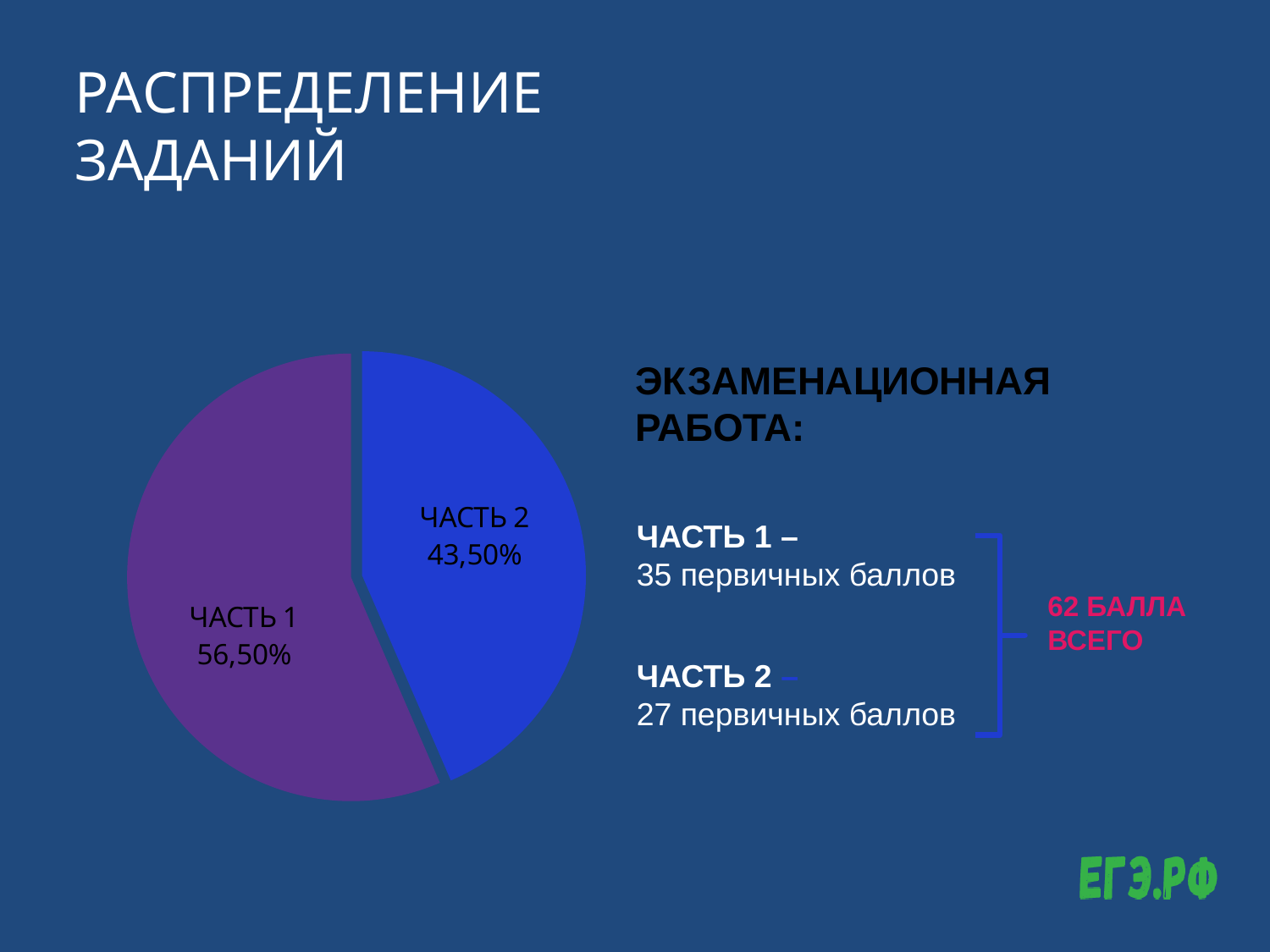
What share of the pie does ЧАСТЬ 2 have? 43,50% Which is larger, the share for ЧАСТЬ 1 or the share for ЧАСТЬ 2? ЧАСТЬ 1 Is the share for ЧАСТЬ 1 greater or less than 50%? greater What is the title of the slide containing the pie chart? РАСПРЕДЕЛЕНИЕ ЗАДАНИЙ What colour is the ЧАСТЬ 2 slice of the pie chart? blue Which slice of the pie is the largest? ЧАСТЬ 1 Which slice of the pie is the smallest? ЧАСТЬ 2 How many slices does the pie chart have? 2 Is the share for ЧАСТЬ 2 greater or less than 50%? less By how many percentage points does the share of ЧАСТЬ 1 exceed the share of ЧАСТЬ 2? 13,00% What kind of chart is shown on the slide? pie chart What share of the pie does ЧАСТЬ 1 have? 56,50%